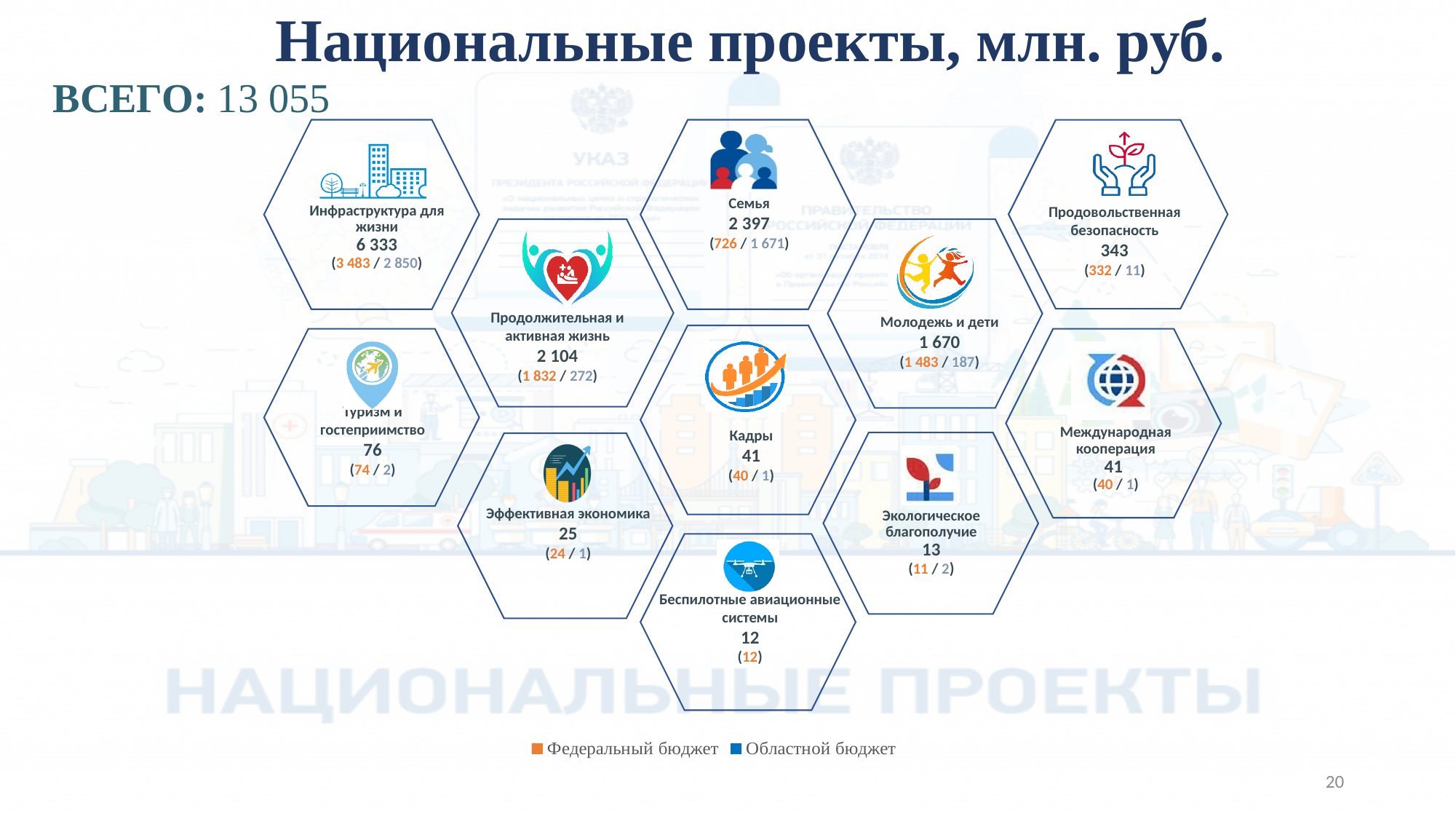
What is the federal budget (Федеральный бюджет) amount shown for "Семья"? 726 Which national project has the lowest total value? Беспилотные авиационные системы What is the overall total (ВСЕГО) shown on the slide? 13 055 Which colour represents "Федеральный бюджет" in the legend? Orange What is the regional budget (Областной бюджет) amount shown for "Молодежь и дети"? 187 What is the difference between the total values of "Семья" and "Продолжительная и активная жизнь"? 293 How many national projects are shown on the slide? 11 Which has a larger total value, "Продовольственная безопасность" or "Туризм и гостеприимство"? Продовольственная безопасность How many budget sources does the legend list? 2 Which national project has the highest total value? Инфраструктура для жизни What is the total value shown for the national project "Инфраструктура для жизни"? 6 333 What is the federal budget amount shown for "Эффективная экономика"? 24